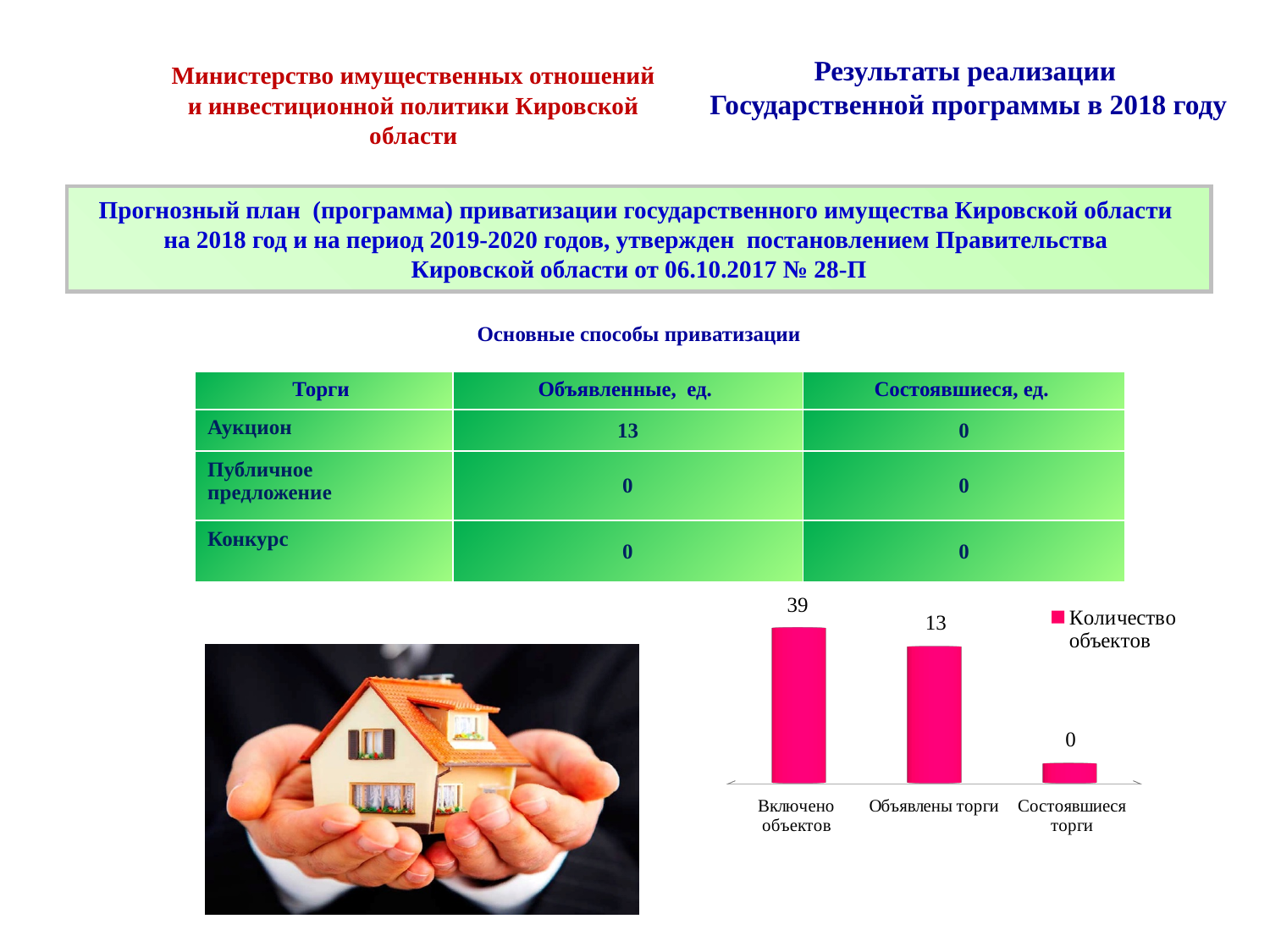
Which is larger in the bar chart: 'Объявлены торги' or 'Состоявшиеся торги'? Объявлены торги How many series does the legend of the bar chart list? 1 How many categories are shown in the bar chart? 3 Which category has the highest value in the bar chart? Включено объектов What kind of chart is shown on the slide? Bar chart What is the value for 'Состоявшиеся торги' in the bar chart? 0 What is the difference between the values for 'Включено объектов' and 'Объявлены торги' in the bar chart? 26 Do the values in the bar chart rise or fall from left to right? Fall Which category has the lowest value in the bar chart? Состоявшиеся торги What is the value for 'Объявлены торги' in the bar chart? 13 What is the name of the series in the bar chart's legend? Количество объектов What is the value for 'Включено объектов' in the bar chart? 39